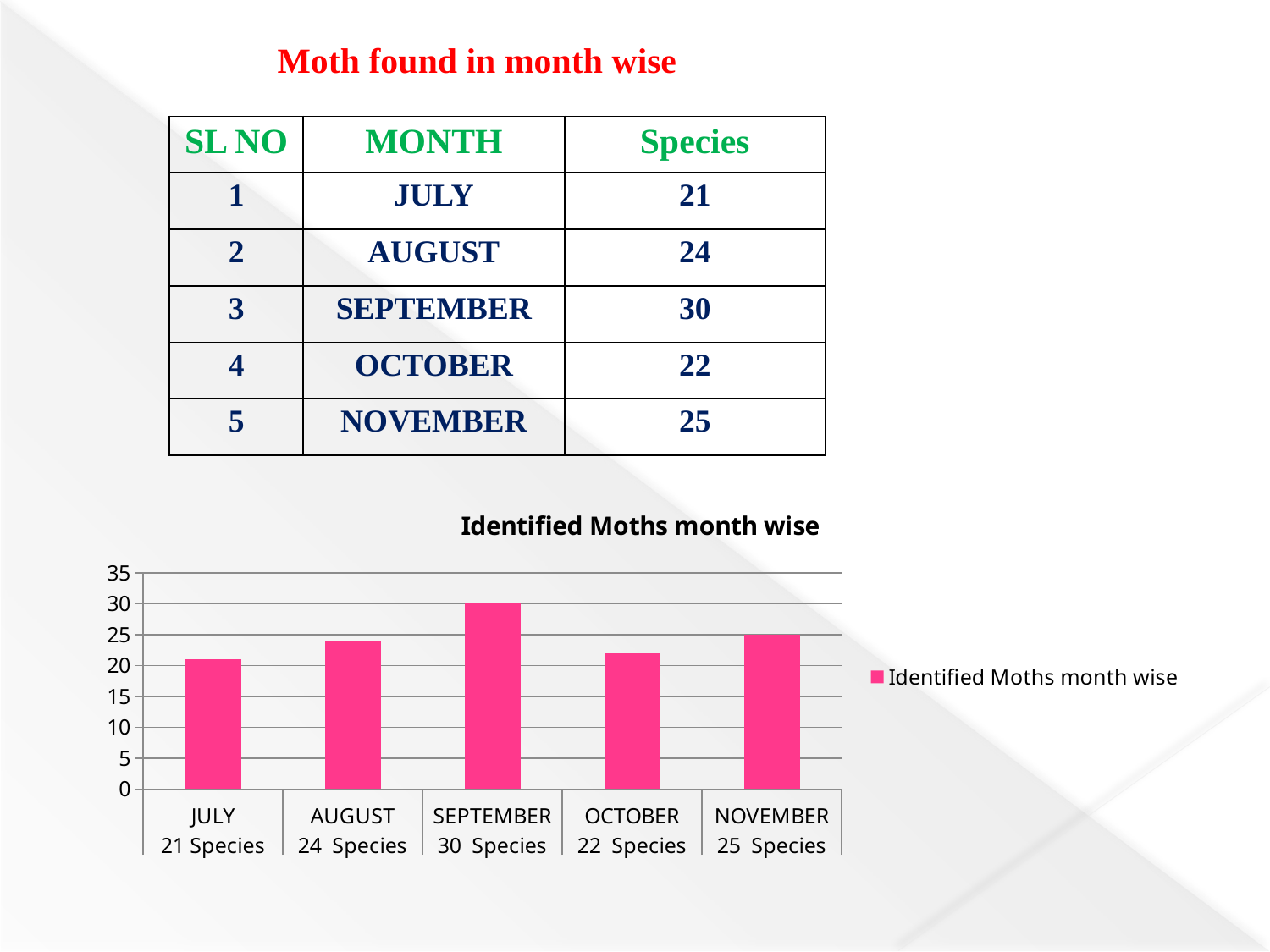
Is the value for OCTOBER greater or less than 25? less Which month has the highest number of identified moth species? SEPTEMBER How many species were identified in SEPTEMBER according to the chart? 30 Species What is the title of the chart? Identified Moths month wise What is the difference between the number of species in SEPTEMBER and OCTOBER? 8 Which month has the lowest number of identified moth species? JULY How many series does the chart legend list? 1 How many species were identified in JULY according to the chart? 21 Species What kind of chart is shown on the slide? bar chart How many months are plotted in the chart? 5 Which month has more identified species, AUGUST or NOVEMBER? NOVEMBER What colour are the bars in the chart? pink